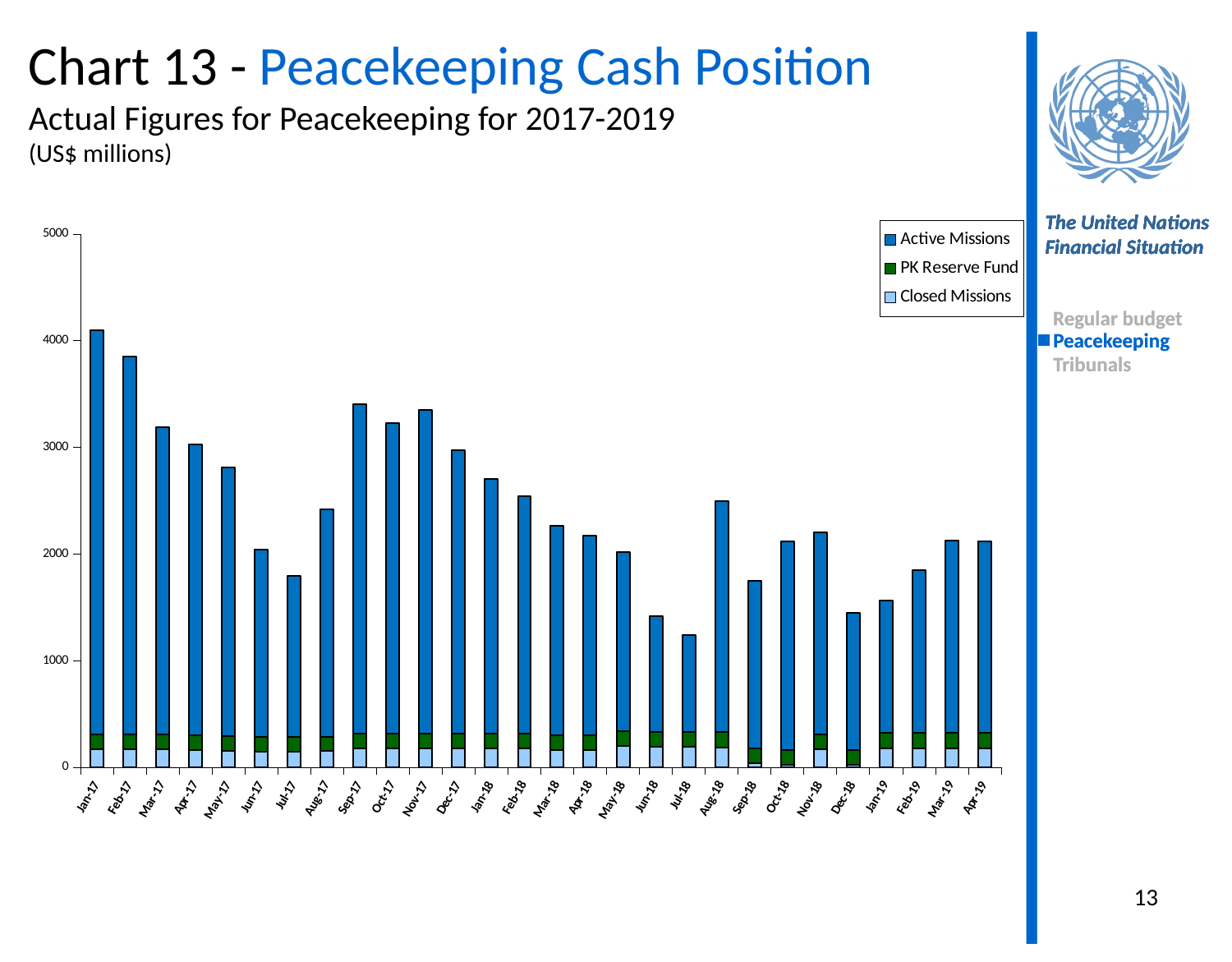
Which month has the larger total bar, Jan-17 or Feb-17? Jan-17 Which month has the highest total bar? Jan-17 Do the total bars rise or fall from Jan-17 to Jul-17? fall Is the total value for Sep-18 greater or less than 2000? less What kind of chart is shown on the slide? Stacked bar chart Is the total value for Aug-18 greater or less than 2000? greater Is the total value for Jul-17 greater or less than 2000? less Which series is shown in dark green in the legend? PK Reserve Fund How many series does the legend list? 3 How many months are plotted along the x axis? 28 Which month has the lowest total bar? Jul-18